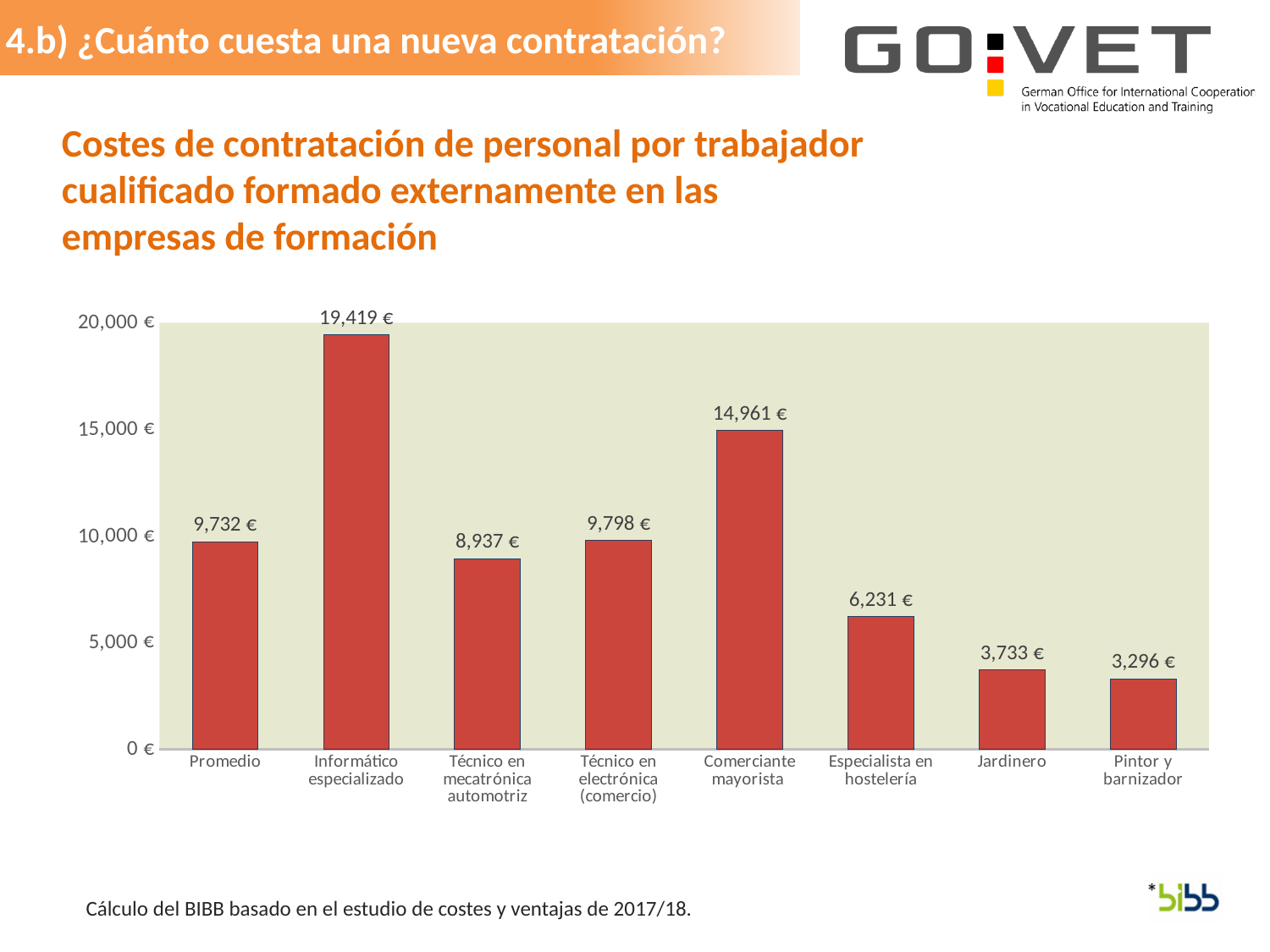
Which is larger, the value for Técnico en electrónica (comercio) or the value for Técnico en mecatrónica automotriz? Técnico en electrónica (comercio) Which category has the highest value? Informático especializado What is the value for Informático especializado? 19,419 € What is the value for Promedio? 9,732 € What is the difference between the values for Jardinero and Pintor y barnizador? 437 € Which category has the lowest value? Pintor y barnizador Is the value for Comerciante mayorista greater or less than 10,000 €? greater How many categories are shown on the x axis? 8 What is the title of the chart? Costes de contratación de personal por trabajador cualificado formado externamente en las empresas de formación What is the difference between the values for Comerciante mayorista and Jardinero? 11,228 € What kind of chart is shown on the slide? bar chart What is the value for Especialista en hostelería? 6,231 €